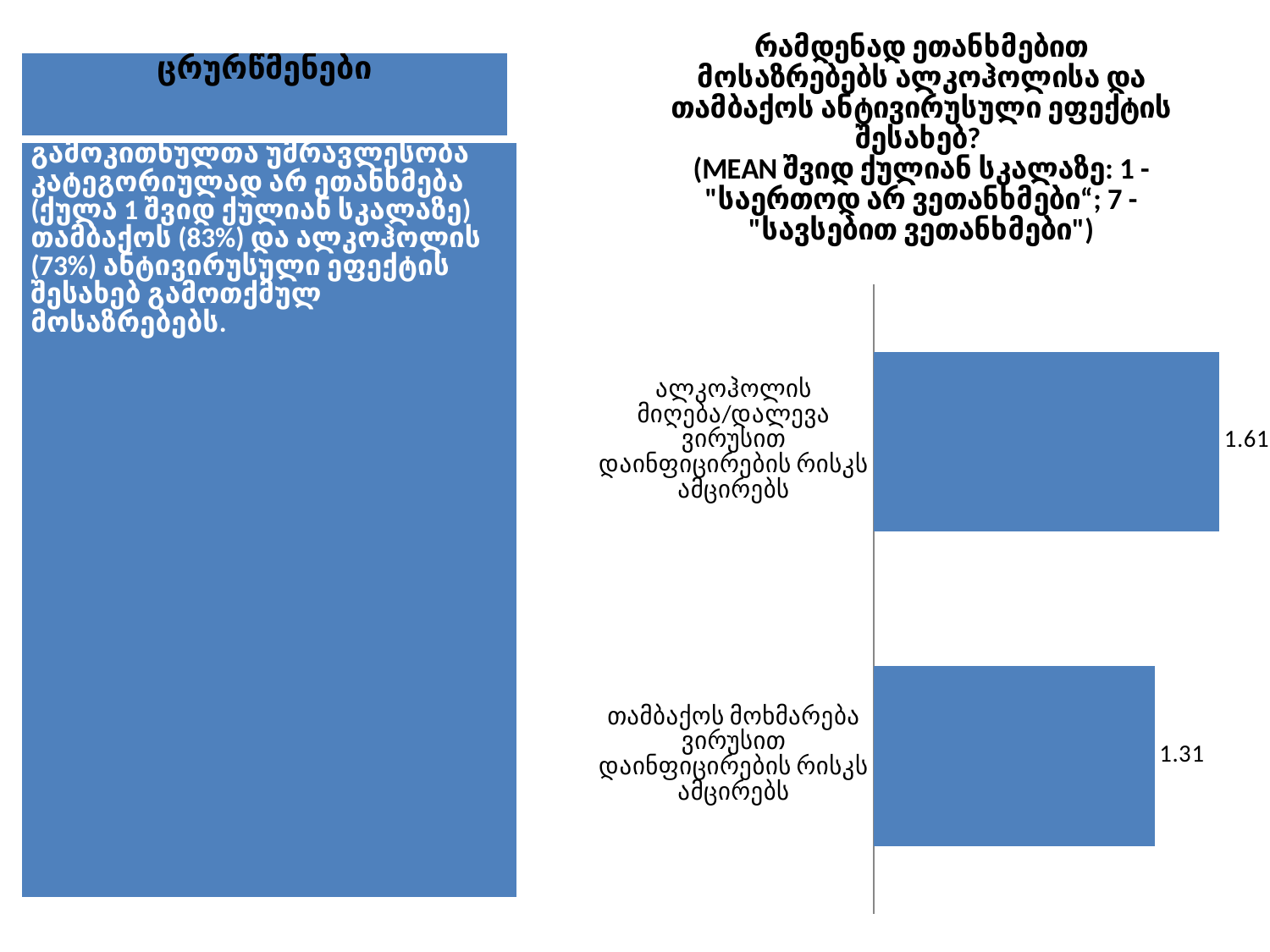
According to the chart title, what is the minimum value of the scale used for the mean? 1 What is the difference between the value for the alcohol statement (ალკოჰოლის მიღება/დალევა...) and the tobacco statement (თამბაქოს მოხმარება...)? 0.30 What kind of chart is shown on the slide? Bar chart How many categories (bars) are plotted in the chart? 2 Which category has the highest value in the chart? ალკოჰოლის მიღება/დალევა ვირუსით დაინფიცირების რისკს ამცირებს Which is larger: the value for the alcohol statement (ალკოჰოლის მიღება/დალევა...) or the tobacco statement (თამბაქოს მოხმარება...)? ალკოჰოლის მიღება/დალევა ვირუსით დაინფიცირების რისკს ამცირებს What value is shown for the bar labelled "ალკოჰოლის მიღება/დალევა ვირუსით დაინფიცირების რისკს ამცირებს"? 1.61 What value is shown for the bar labelled "თამბაქოს მოხმარება ვირუსით დაინფიცირების რისკს ამცირებს"? 1.31 According to the chart title, what is the maximum value of the scale used for the mean? 7 Which category has the lowest value in the chart? თამბაქოს მოხმარება ვირუსით დაინფიცირების რისკს ამცირებს